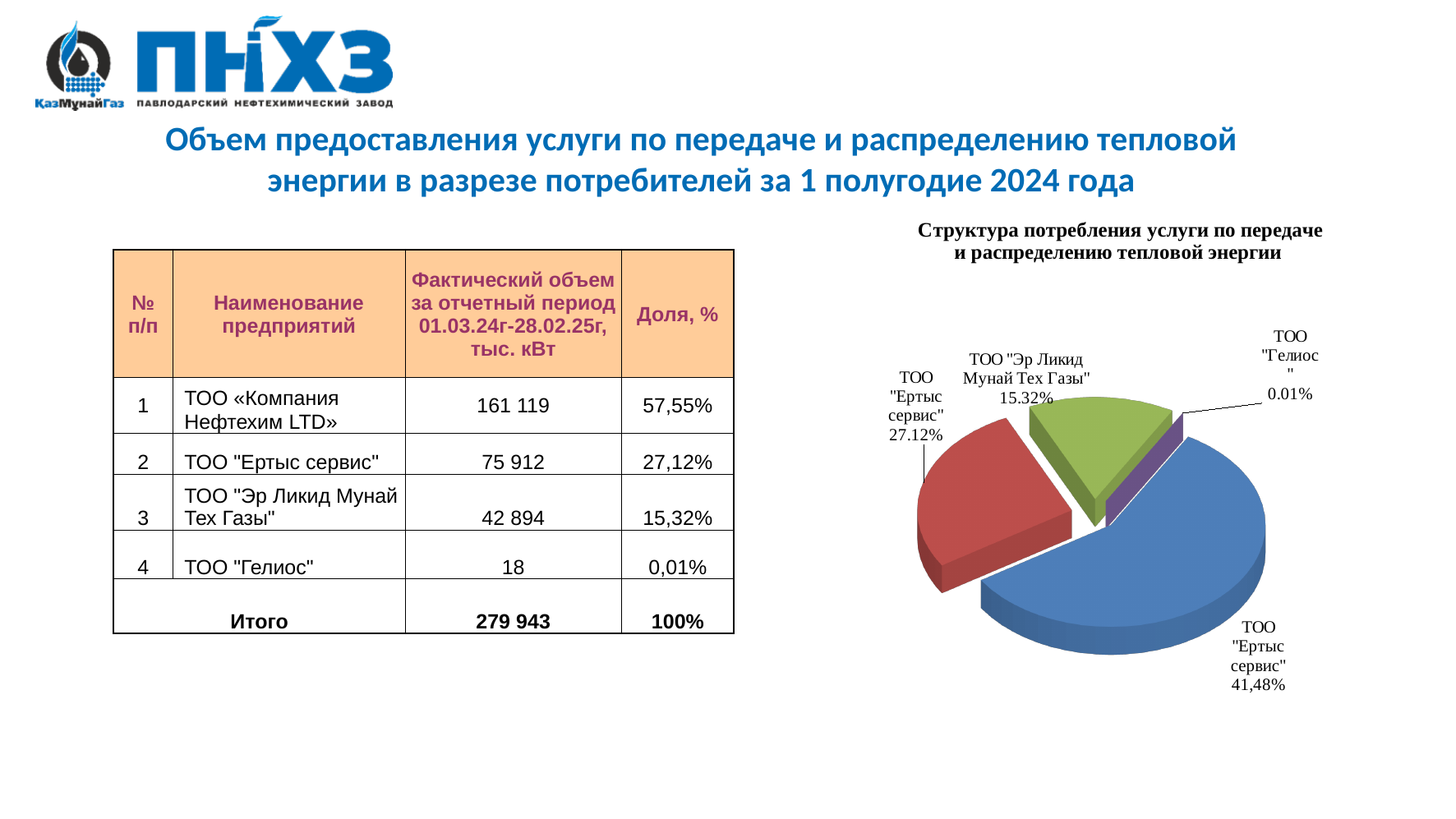
In the pie chart, what is the difference between the share for ТОО "Эр Ликид Мунай Тех Газы" and the share for ТОО "Гелиос"? 15.31% What colour is the slice for ТОО "Эр Ликид Мунай Тех Газы" in the pie chart? green What percentage is shown for ТОО "Гелиос" in the pie chart? 0.01% How many slices does the pie chart have? 4 Which slice of the pie chart is the smallest? ТОО "Гелиос" What percentage label is shown on the largest slice of the pie chart? 41,48% What is the title of the pie chart? Структура потребления услуги по передаче и распределению тепловой энергии What percentage is shown on the red slice of the pie chart? 27.12% In the pie chart, which is larger: the share for ТОО "Эр Ликид Мунай Тех Газы" or the share for ТОО "Гелиос"? ТОО "Эр Ликид Мунай Тех Газы" What kind of chart is shown on the right side of the slide? pie chart What percentage is shown for ТОО "Эр Ликид Мунай Тех Газы" in the pie chart? 15.32%